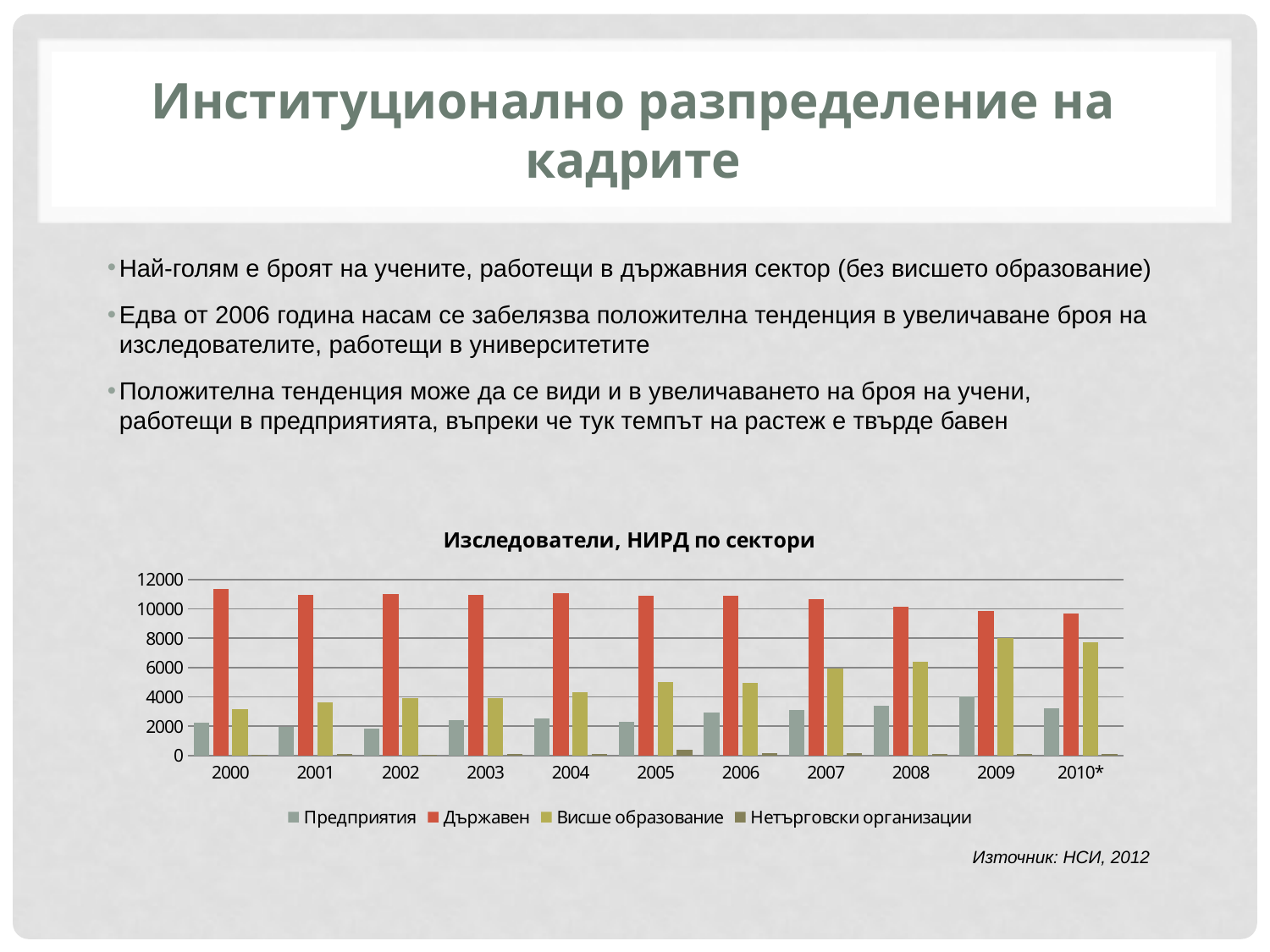
Do the values for Висше образование rise or fall from 2005 to 2009? rise What is the title of the chart? Изследователи, НИРД по сектори How many years are shown along the x axis of the chart? 11 Which series has the lowest values across all years in the chart? Нетърговски организации Is the value for Висше образование in 2009 greater or less than 6000? greater Is the value for Държавен in 2000 greater or less than 10000? greater What kind of chart is shown on the slide? bar chart Is the value for Предприятия in 2001 greater or less than 4000? less How many series does the legend of the chart list? 4 Which series is drawn in red in the chart? Държавен In 2010*, which is larger: the value for Държавен or the value for Висше образование? Държавен